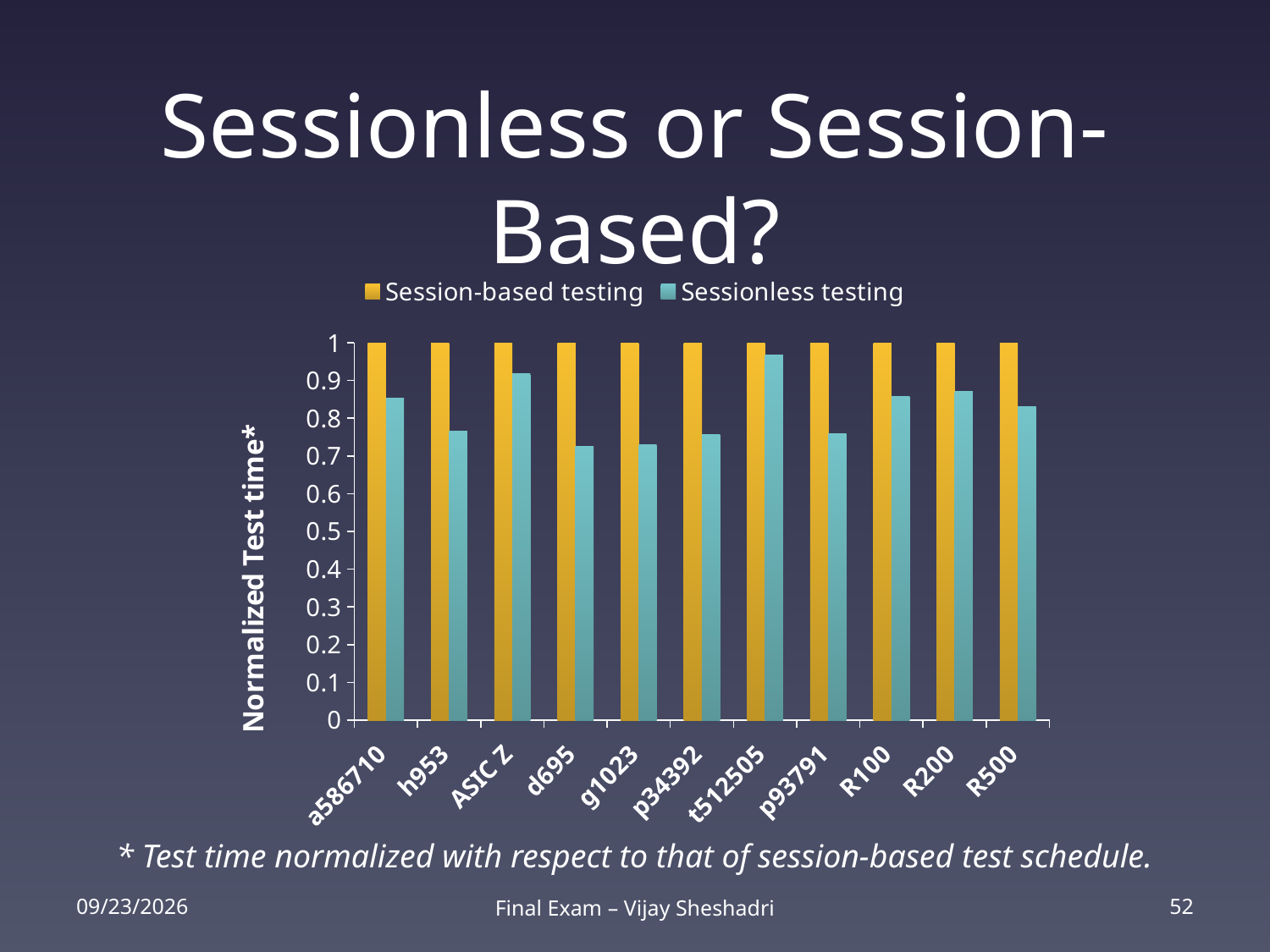
Which category has the highest Sessionless testing value? t512505 What is the title of the y axis? Normalized Test time* What is the Session-based testing value for R500? 1 How many series does the legend list? 2 Which is larger, the Sessionless testing value for t512505 or for R100? t512505 Is the Sessionless testing value for h953 greater or less than 0.8? less Is the Sessionless testing value for ASIC Z greater or less than 0.9? greater How many categories are shown on the x axis? 11 What is the Session-based testing value for d695? 1 What kind of chart is shown on the slide? bar chart Which is larger, the Sessionless testing value for ASIC Z or for d695? ASIC Z Is the Sessionless testing value for d695 greater or less than 0.8? less